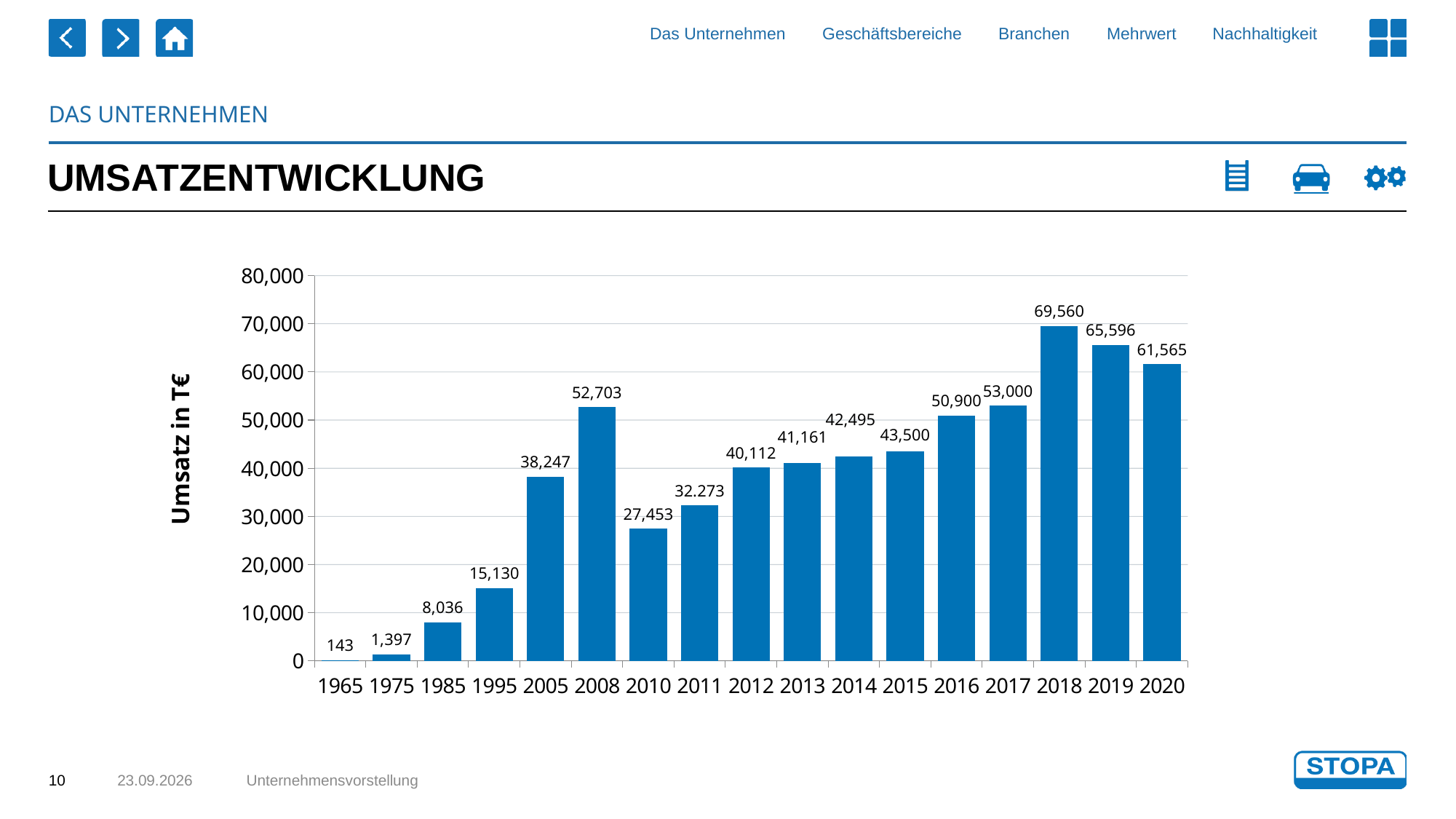
What is the label of the y axis? Umsatz in T€ Is the value for 2005 greater or less than 40,000? less What kind of chart is shown? bar chart Which year has the highest value? 2018 How many years are shown on the x axis? 17 Which is larger, the value for 2008 or the value for 2010? 2008 What is the difference between the values for 2018 and 2019? 3,964 Which year has the lowest value? 1965 What is the value for 2011 as printed on the chart? 32.273 What is the value for 1965? 143 What is the value for 2018? 69,560 What is the difference between the values for 2017 and 2016? 2,100